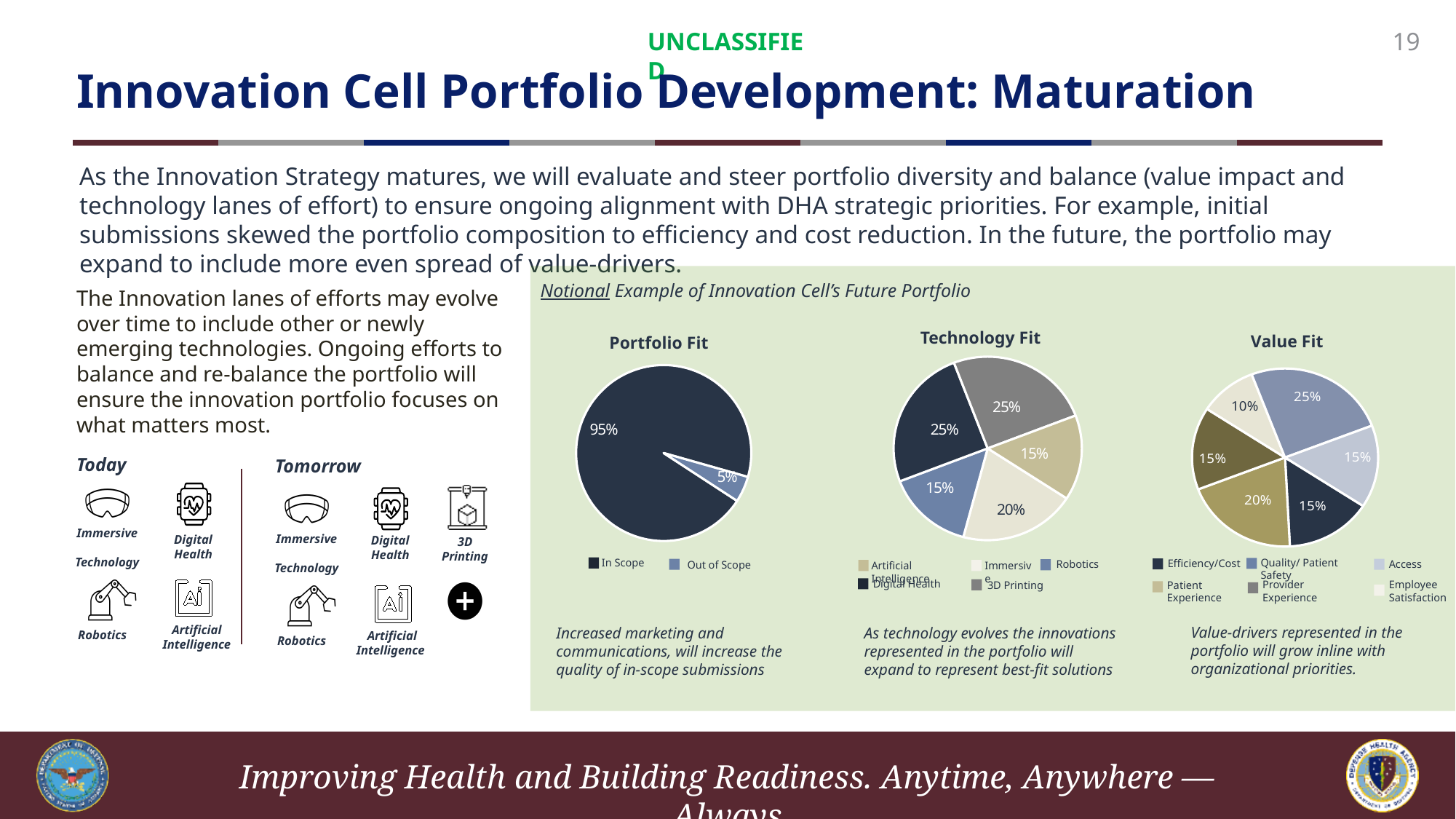
In the Portfolio Fit chart, what share is In Scope? 95% In the Value Fit chart, which is larger: Quality/ Patient Safety or Efficiency/Cost? Quality/ Patient Safety How many entries does the legend of the Value Fit chart list? 6 In the Portfolio Fit chart, what share is Out of Scope? 5% In the Value Fit chart, what share is Patient Experience? 20% What kind of chart is the Technology Fit chart? pie chart How many slices does the Technology Fit chart have? 5 In the Technology Fit chart, what share is Immersive? 20% In the Value Fit chart, which value-driver has the smallest share? Employee Satisfaction In the Technology Fit chart, what share is Digital Health? 25% In the Value Fit chart, which value-driver has the largest share? Quality/ Patient Safety In the Technology Fit chart, what is the difference between the 3D Printing share and the Robotics share? 10%